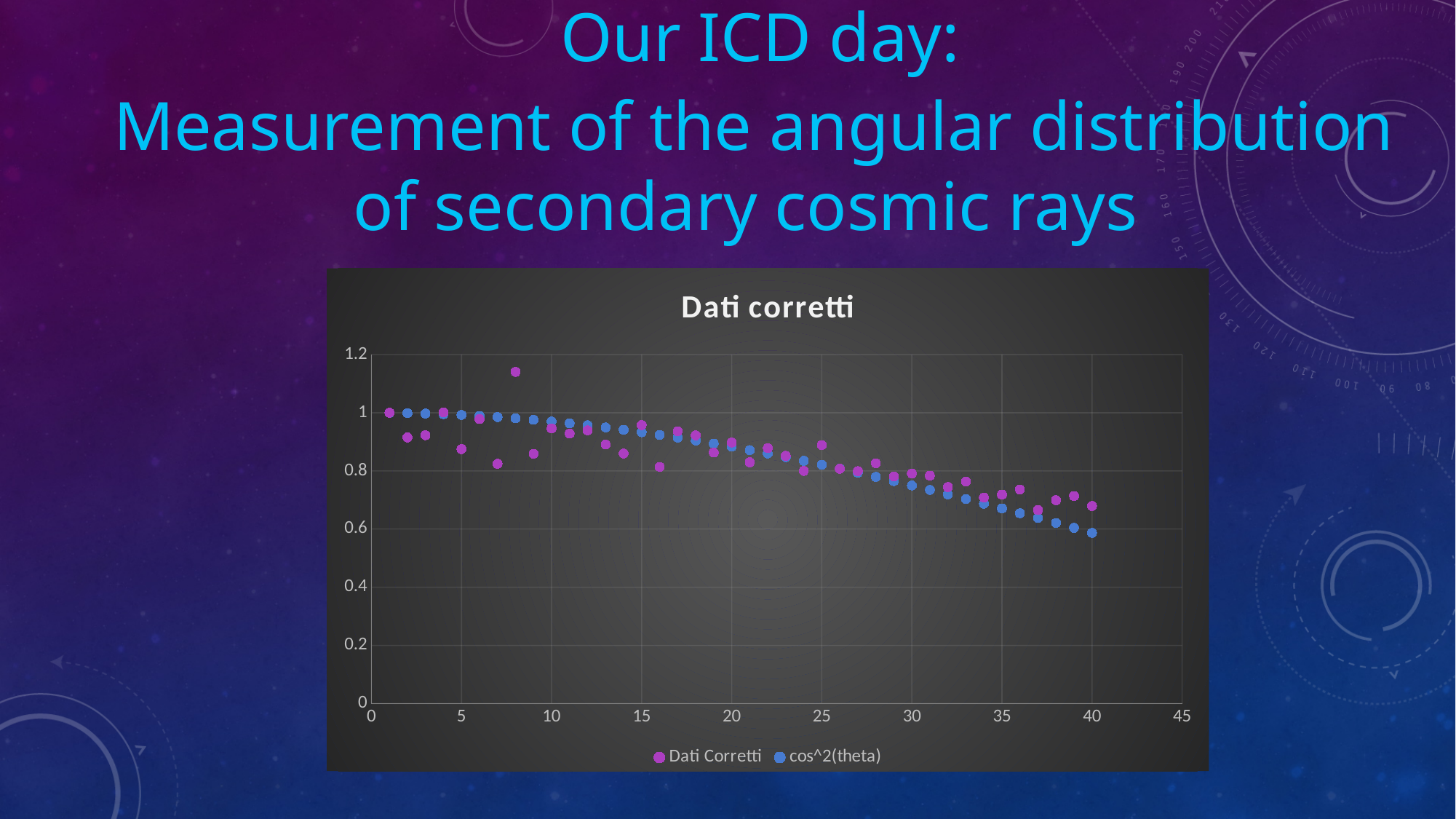
At x = 40, which series has the higher value, Dati Corretti or cos^2(theta)? Dati Corretti Is the Dati Corretti value at x = 8 greater or less than 1? greater Do the cos^2(theta) values rise or fall as the x value increases? fall Do the Dati Corretti values generally rise or fall as the x value increases? fall What is the title of the chart? Dati corretti Is the Dati Corretti value at x = 40 greater or less than 0.6? greater Is the cos^2(theta) value at x = 30 greater or less than 0.8? less Which series is drawn in blue in the chart? cos^2(theta) At which x value does the Dati Corretti series reach its highest point? 8 What kind of chart is shown on the slide? scatter chart How many series does the legend of the chart list? 2